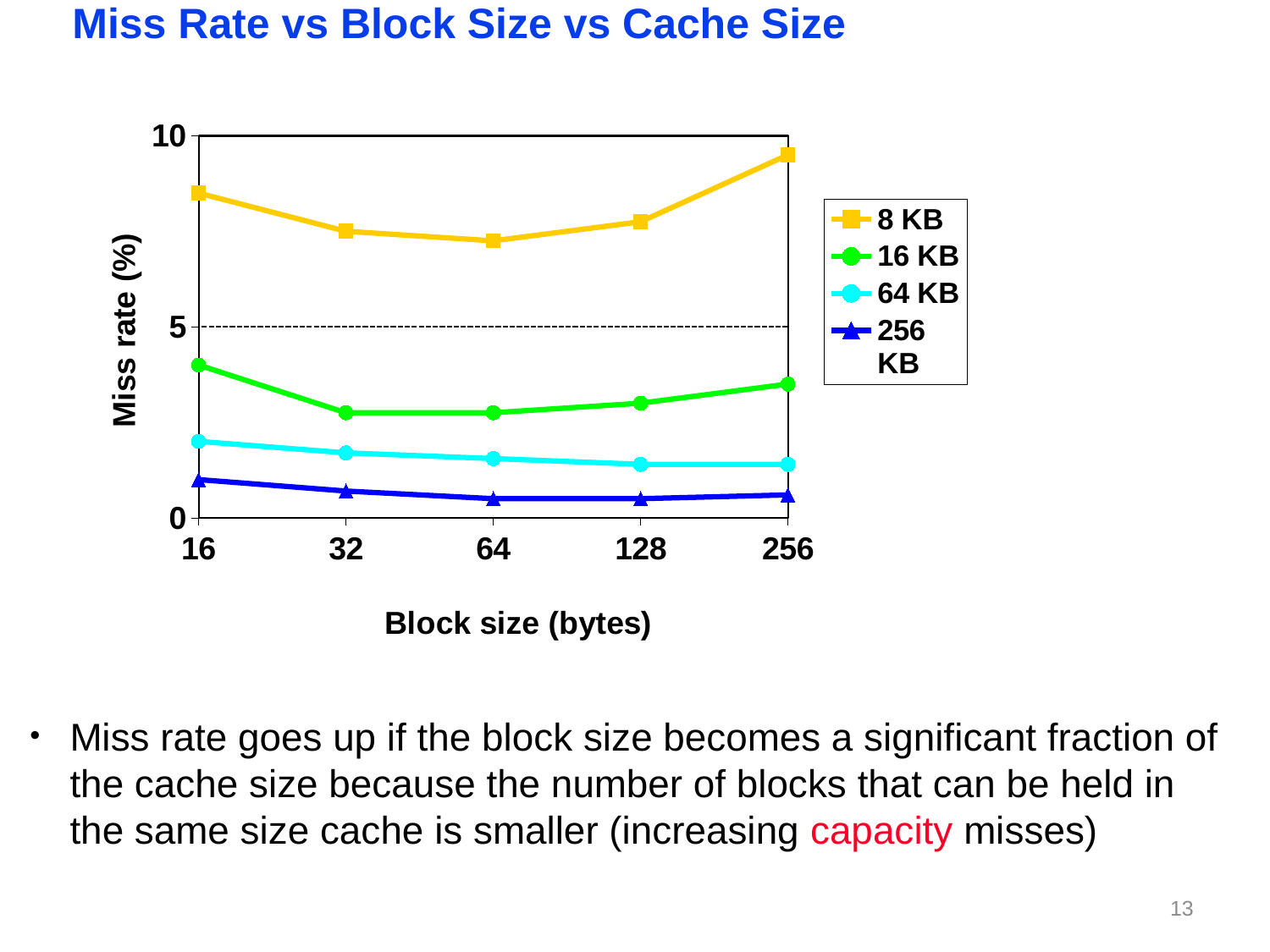
At block size 256, which has the higher miss rate: the 8 KB cache or the 16 KB cache? 8 KB Which cache size has the highest miss rate at block size 16? 8 KB How many block sizes are plotted along the x axis? 5 Does the miss rate for the 8 KB cache rise or fall from block size 128 to block size 256? rise Is the miss rate for the 8 KB cache at block size 16 greater or less than 5? greater Is the miss rate for the 16 KB cache at block size 16 greater or less than 5? less What is the title of the x axis? Block size (bytes) How many series does the legend list? 4 Which cache size has the lowest miss rate at block size 64? 256 KB For the 8 KB cache, at which block size is the miss rate highest? 256 Is the miss rate for the 256 KB cache at block size 256 greater or less than 5? less What kind of chart is shown on the slide? line chart